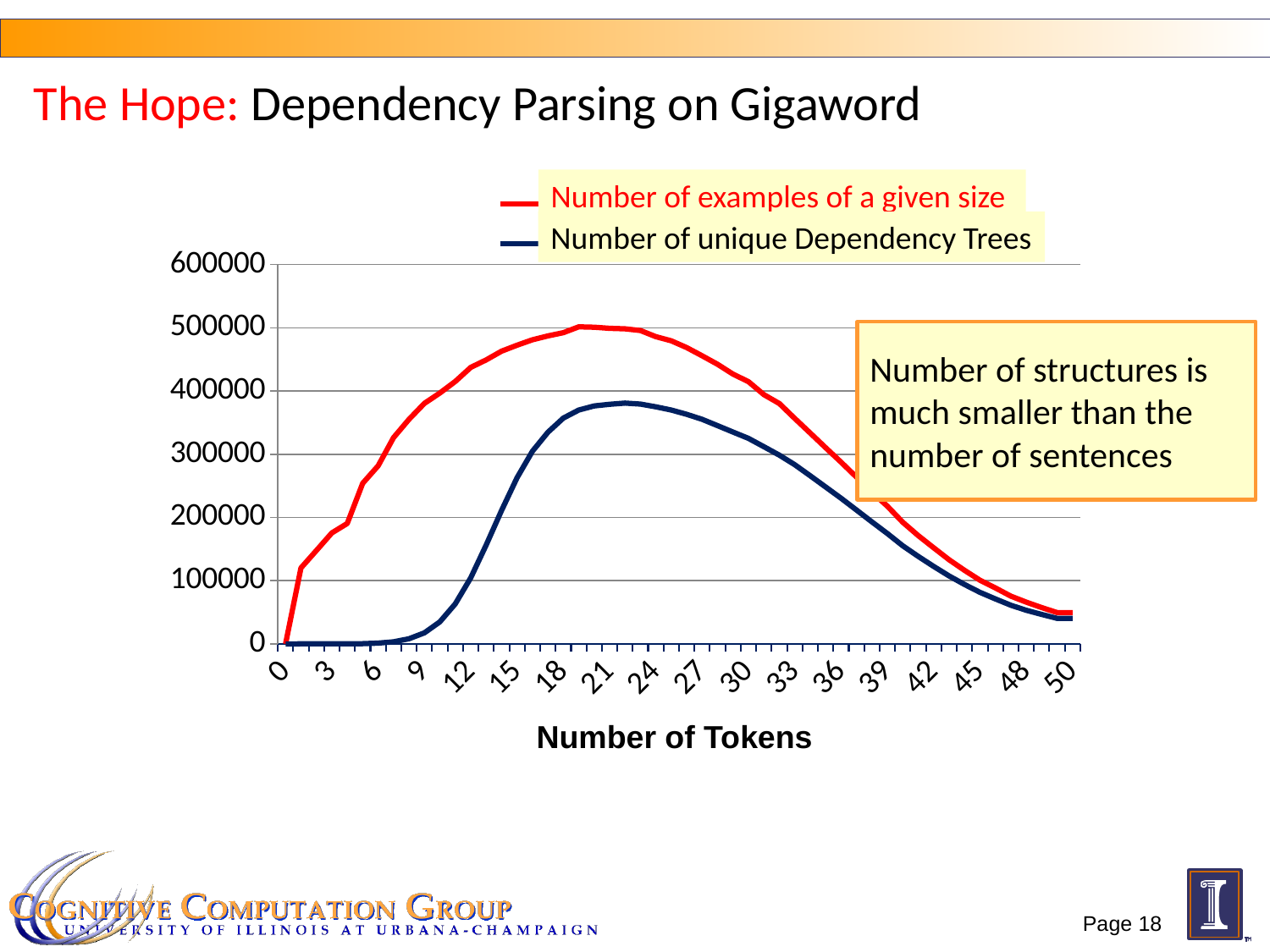
Is the value of Number of examples of a given size at 12 tokens greater or less than 400000? greater Which series is drawn in red? Number of examples of a given size Is the value of Number of examples of a given size at 3 tokens greater or less than 100000? greater Is the value of Number of unique Dependency Trees at 9 tokens greater or less than 100000? less At 12 tokens, which series has the larger value: Number of examples of a given size or Number of unique Dependency Trees? Number of examples of a given size What is the title of the x axis? Number of Tokens Does the Number of examples of a given size rise or fall as the number of tokens increases from 24 to 50? fall What kind of chart is shown on the slide? line chart Which series reaches the higher peak value? Number of examples of a given size How many series does the legend list? 2